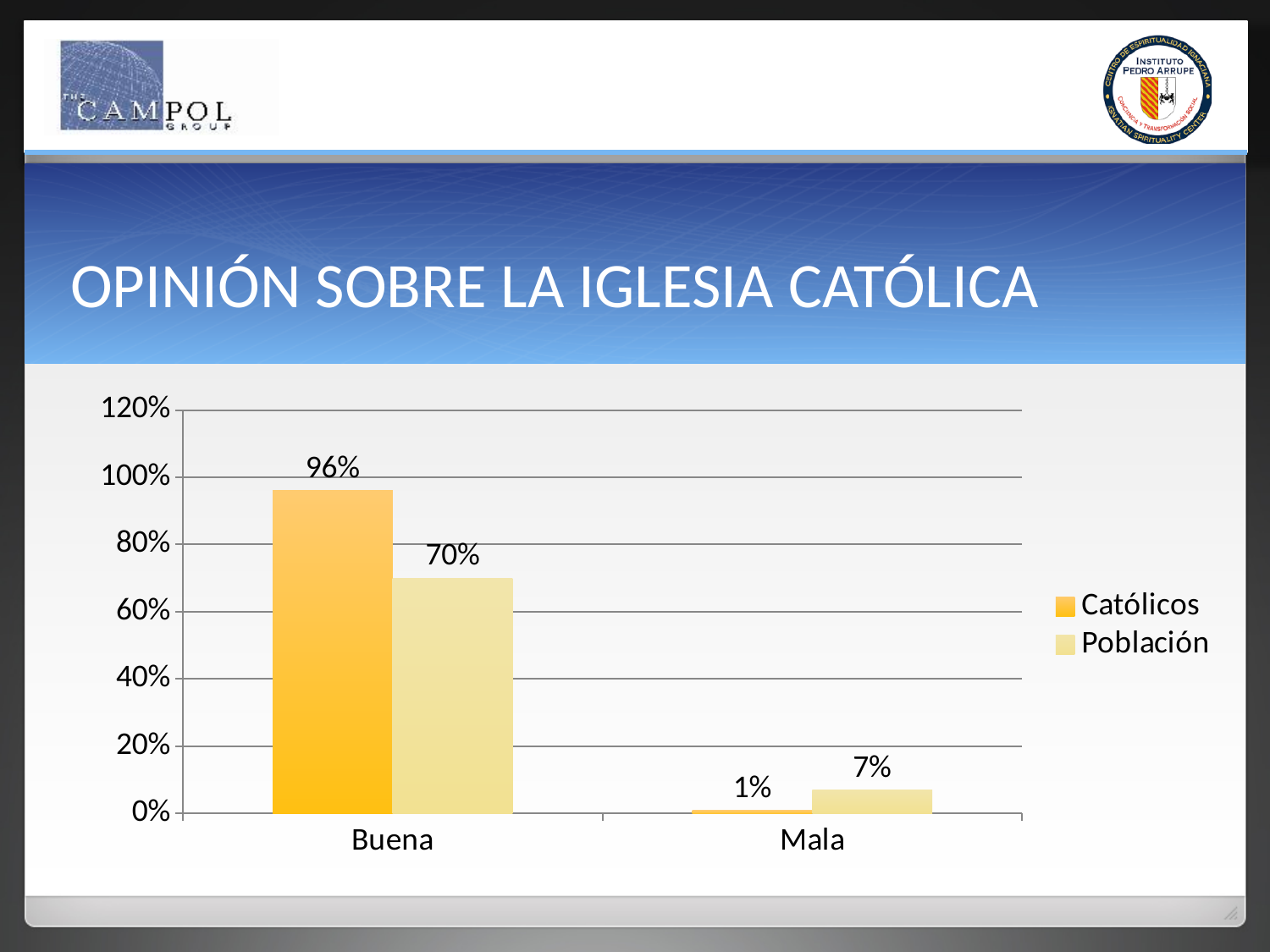
What is the difference between the Católicos and Población values for Buena? 26% Which series has the lowest value in the Mala category? Católicos How many categories are shown on the x axis? 2 What is the difference between the Población and Católicos values for Mala? 6% What kind of chart is shown on the slide? Bar chart What is the value for Población in the Buena category? 70% What is the value for Católicos in the Mala category? 1% What is the value for Población in the Mala category? 7% Which is larger: Población for Buena or Población for Mala? Población for Buena Which series has the highest value in the Buena category? Católicos How many series does the legend list? 2 What is the value for Católicos in the Buena category? 96%